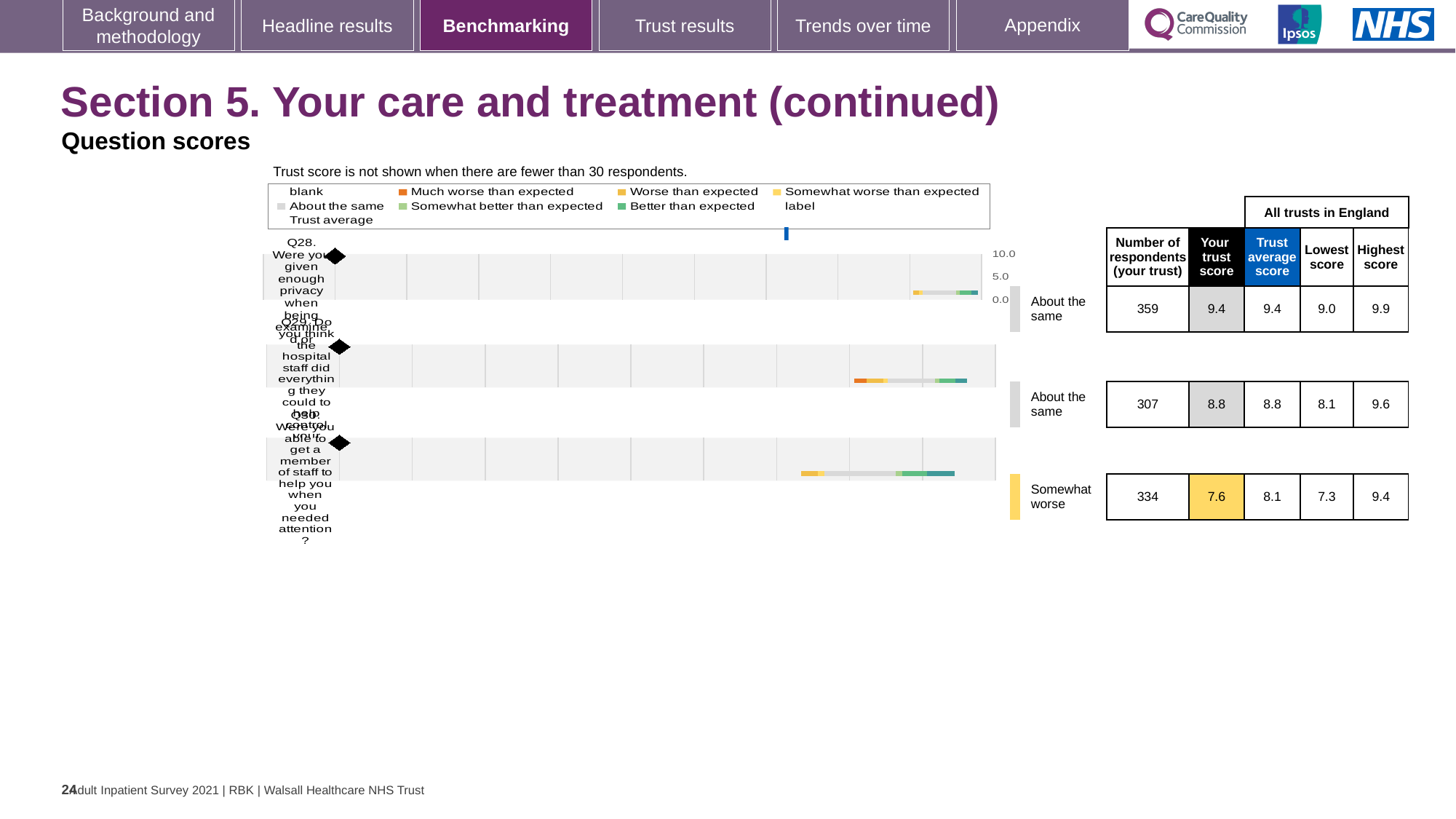
According to the note above the chart, when is the trust score not shown? When there are fewer than 30 respondents What is the highest score across all trusts in England for Q30 (Were you able to get a member of staff to help you when you needed attention?)? 9.4 What is the trust score for Q28 (Were you given enough privacy when being examined or treated?)? 9.4 Which question has the lowest trust score on this slide? Q30 What is the difference between the trust average score and this trust's score for Q30? 0.5 How many questions are plotted on the chart? 3 What is the lowest score across all trusts in England for Q29? 8.1 How many respondents answered Q29 (Do you think the hospital staff did everything they could to help control your pain?) at this trust? 307 Which has the higher trust score, Q28 or Q29? Q28 What benchmark category is shown for Q30? Somewhat worse What kind of chart is used to show the question scores? Bar chart Which question has the highest number of respondents? Q28